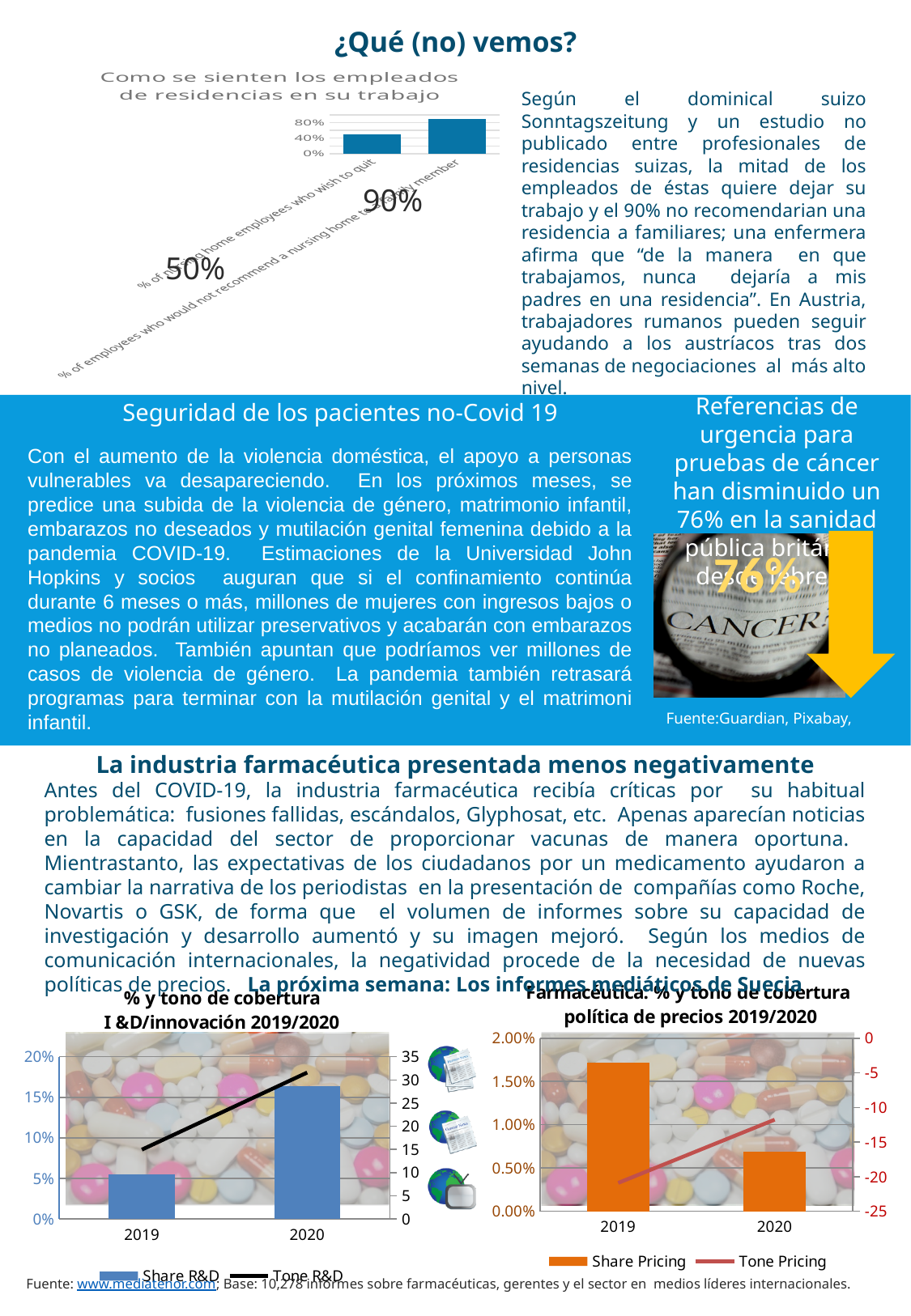
In the chart titled '% y tono de cobertura I&D/innovación 2019/2020', is the Share R&D value for 2019 greater or less than 10%? less In the chart titled 'Farmacéutica: % y tono de cobertura política de precios 2019/2020', is the Share Pricing value for 2019 greater or less than 1.50%? greater In the chart titled 'Farmacéutica: % y tono de cobertura política de precios 2019/2020', which year has the lower Share Pricing bar? 2020 In the chart titled '% y tono de cobertura I&D/innovación 2019/2020', does the Tone R&D line rise or fall from 2019 to 2020? rise In the chart titled '% y tono de cobertura I&D/innovación 2019/2020', how many series does the legend list? 2 In the chart titled 'Como se sienten los empleados de residencias en su trabajo', what is the value for '% of nursing home employees who wish to quit'? 50% In the chart titled 'Como se sienten los empleados de residencias en su trabajo', what is the difference between the two bars? 40% In the chart titled 'Como se sienten los empleados de residencias en su trabajo', what is the value for '% of employees who would not recommend a nursing home to a family member'? 90% In the chart titled '% y tono de cobertura I&D/innovación 2019/2020', is the Share R&D value for 2020 greater or less than 15%? greater In the chart titled '% y tono de cobertura I&D/innovación 2019/2020', which year has the higher Share R&D bar? 2020 In the chart titled 'Farmacéutica: % y tono de cobertura política de precios 2019/2020', what are the two legend entries? Share Pricing, Tone Pricing In the chart titled 'Como se sienten los empleados de residencias en su trabajo', how many bars are plotted? 2